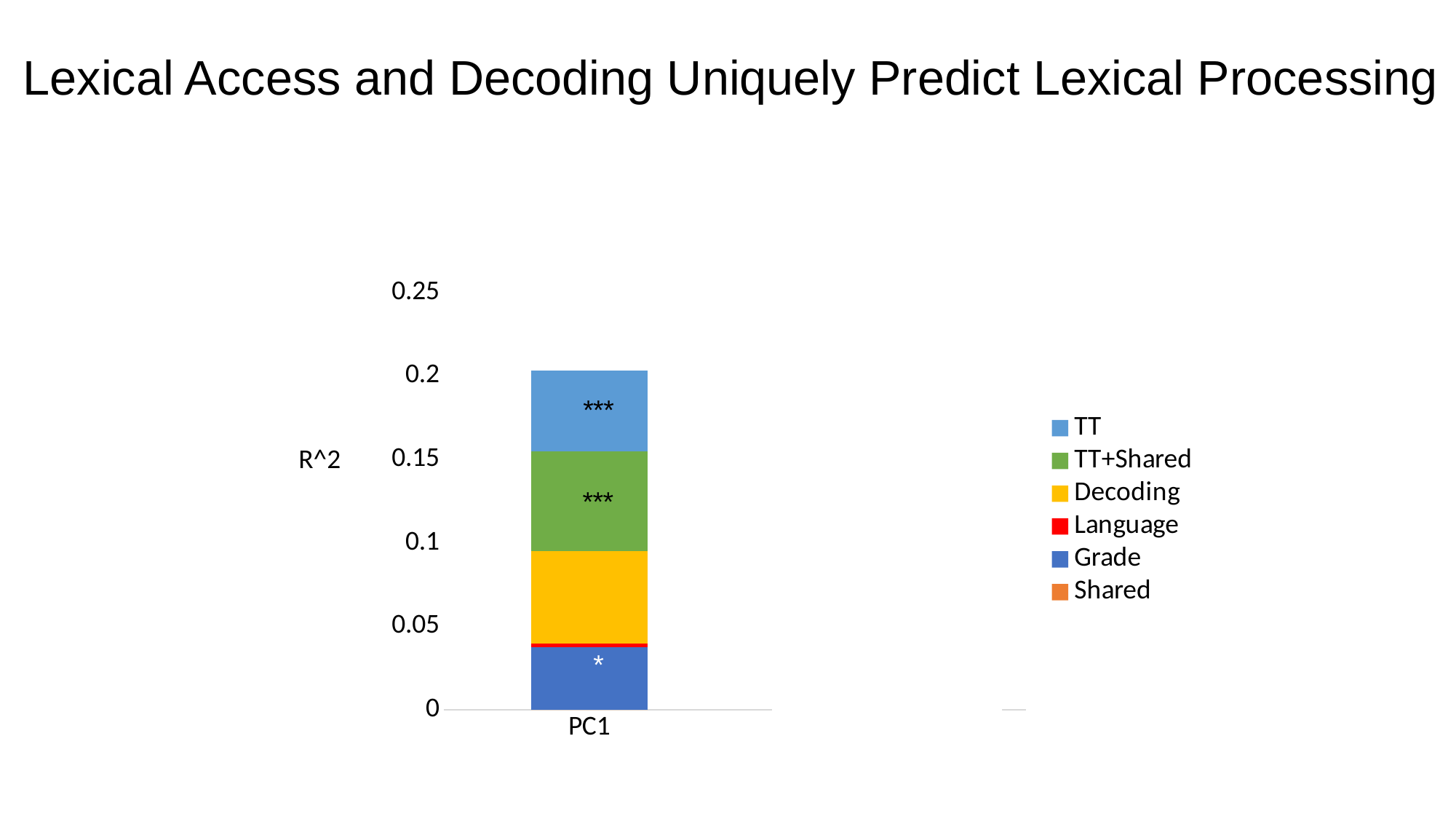
What kind of chart is shown on the slide? stacked bar chart How many series does the chart's legend list? 6 How many categories are shown on the x axis of the chart? 1 In the PC1 bar, which segment is larger: Decoding or Language? Decoding Is the total height of the PC1 stacked bar greater or less than 0.25? less In the PC1 bar, which segment is larger: Grade or Language? Grade What is the label on the y axis of the chart? R^2 Is the total height of the PC1 stacked bar greater or less than 0.15? greater What is the label of the single category on the x axis? PC1 Is the top of the Grade segment in the PC1 bar greater or less than 0.05? less In the PC1 bar, which segment is larger: TT or Language? TT